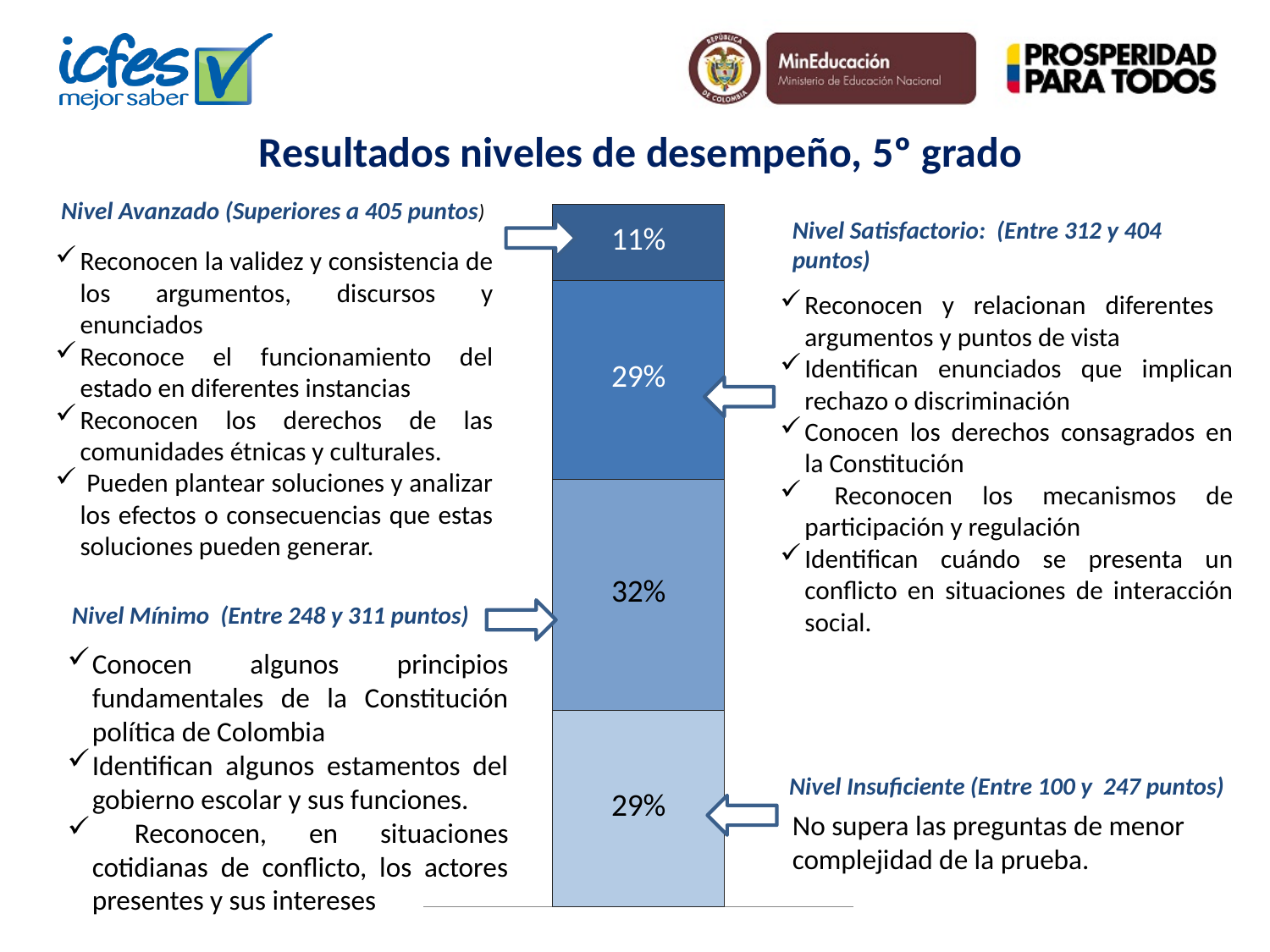
What percentage is shown for the Nivel Satisfactorio segment of the stacked bar? 29% What is the title of the slide containing the chart? Resultados niveles de desempeño, 5º grado What percentage is shown for the Nivel Avanzado segment of the stacked bar? 11% Which is larger, the Nivel Mínimo segment or the Nivel Satisfactorio segment? Nivel Mínimo What is the difference in percentage points between the Nivel Mínimo segment and the Nivel Avanzado segment? 21 What is the total of all the segments in the stacked bar? 101% What kind of chart is shown on the slide? Stacked bar chart What percentage is shown for the Nivel Insuficiente segment of the stacked bar? 29% Which performance level has the largest share in the stacked bar? Nivel Mínimo Which performance level has the smallest share in the stacked bar? Nivel Avanzado How many segments does the stacked bar contain? 4 What percentage is shown for the Nivel Mínimo segment of the stacked bar? 32%